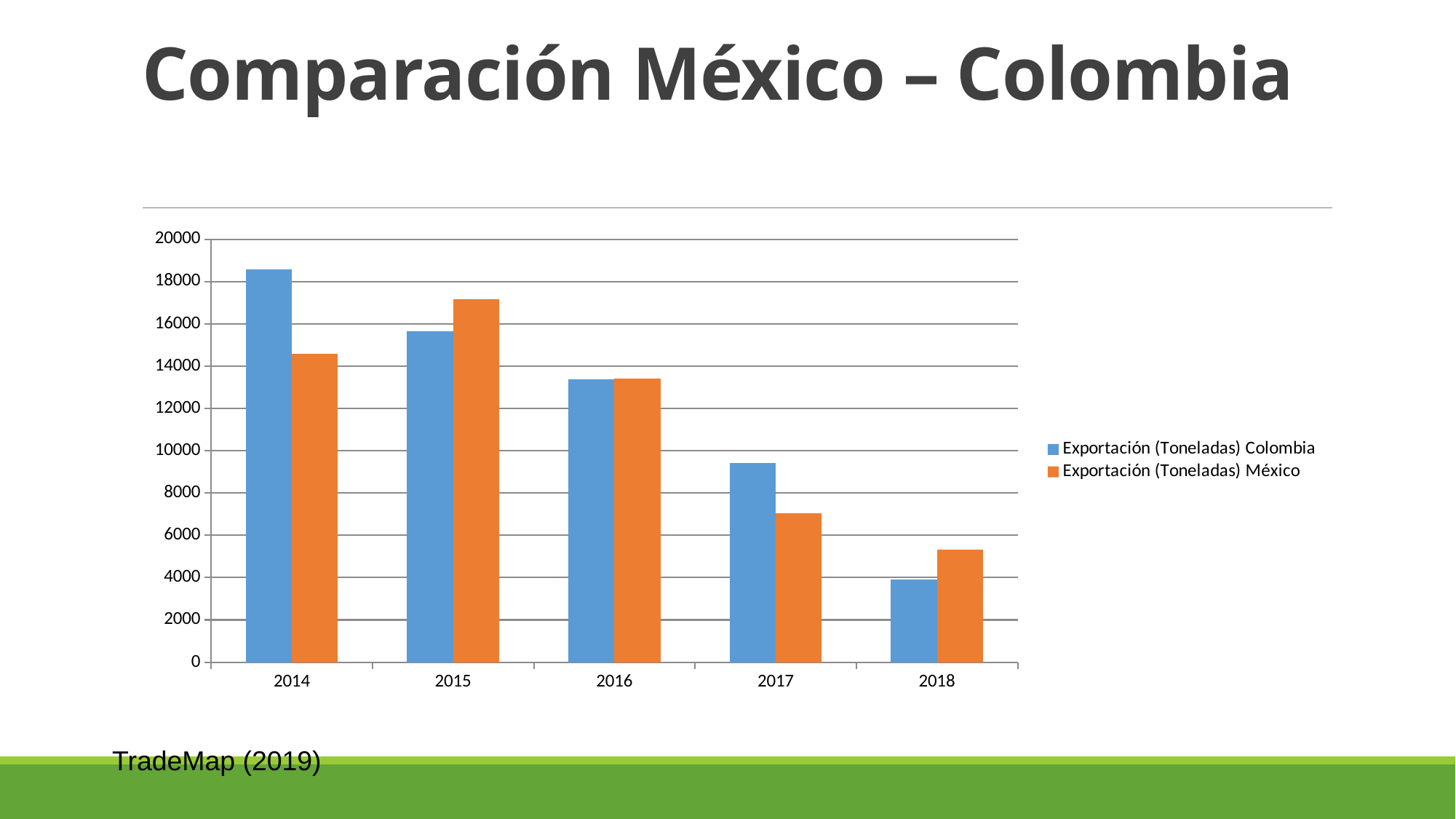
In 2014, which is larger: Exportación (Toneladas) Colombia or Exportación (Toneladas) México? Exportación (Toneladas) Colombia Is the value for Exportación (Toneladas) Colombia in 2014 greater or less than 18000? greater How many series does the legend list? 2 In which year is the value for Exportación (Toneladas) México lowest? 2018 In which year is the value for Exportación (Toneladas) México highest? 2015 Is the value for Exportación (Toneladas) México in 2017 greater or less than 8000? less In which year is the value for Exportación (Toneladas) Colombia highest? 2014 Does the value for Exportación (Toneladas) Colombia rise or fall from 2014 to 2018? fall How many years are shown on the x axis? 5 In 2018, which is larger: Exportación (Toneladas) Colombia or Exportación (Toneladas) México? Exportación (Toneladas) México In which year is the value for Exportación (Toneladas) Colombia lowest? 2018 What kind of chart is shown on the slide? bar chart